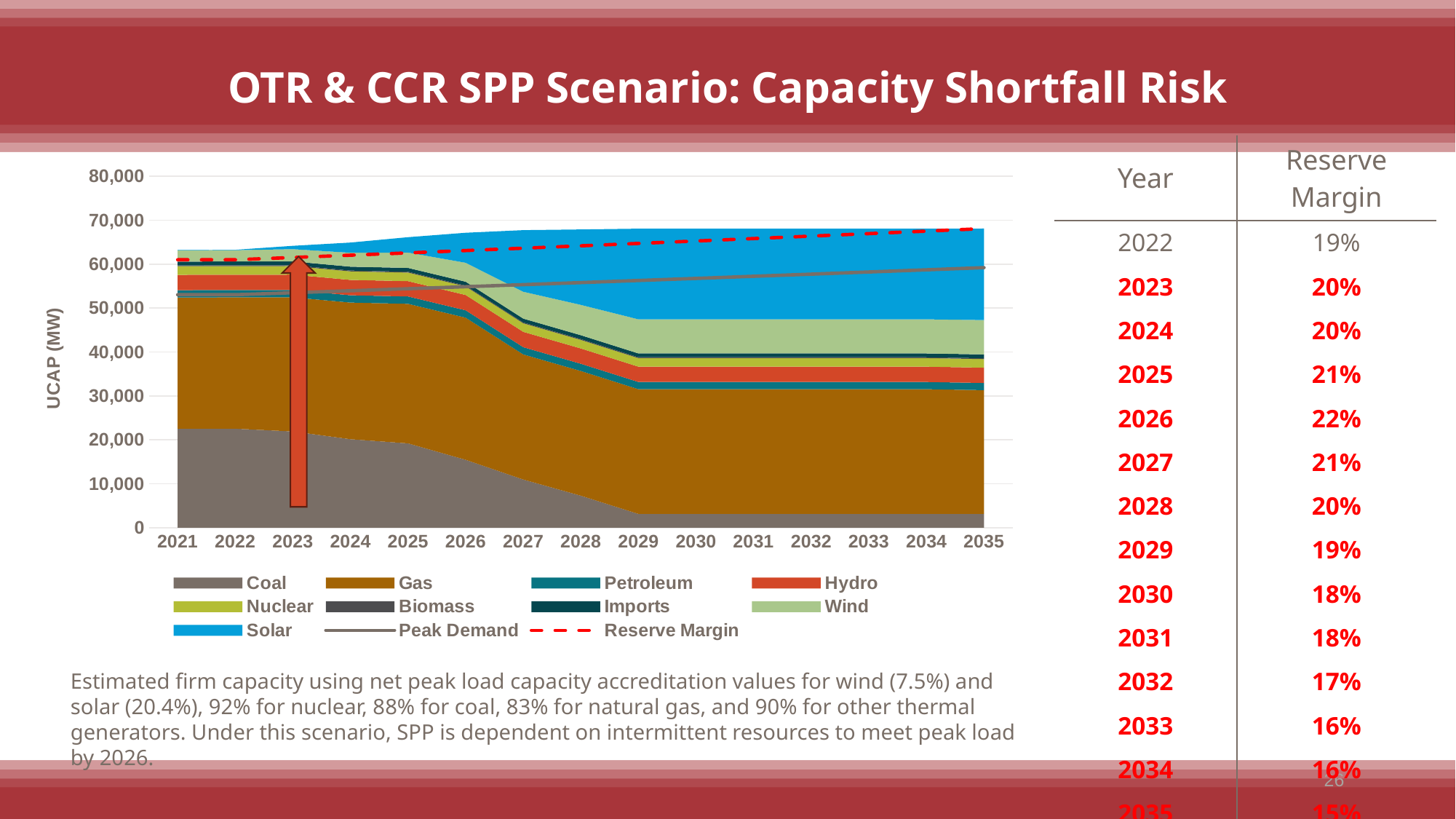
Is the total stacked capacity in 2035 greater or less than 60,000? greater Which series in the chart is drawn as a red dashed line? Reserve Margin Is the Coal capacity in 2035 greater or less than 10,000? less How many series does the chart legend list? 11 Is the Coal capacity in 2021 greater or less than 20,000? greater Does the Coal area rise or fall from 2021 to 2035? fall How many years are shown along the x axis of the chart? 15 What kind of chart is shown on the slide? combination stacked area and line chart Does the Peak Demand line rise or fall from 2021 to 2035? rise What is the label on the y axis of the chart? UCAP (MW)